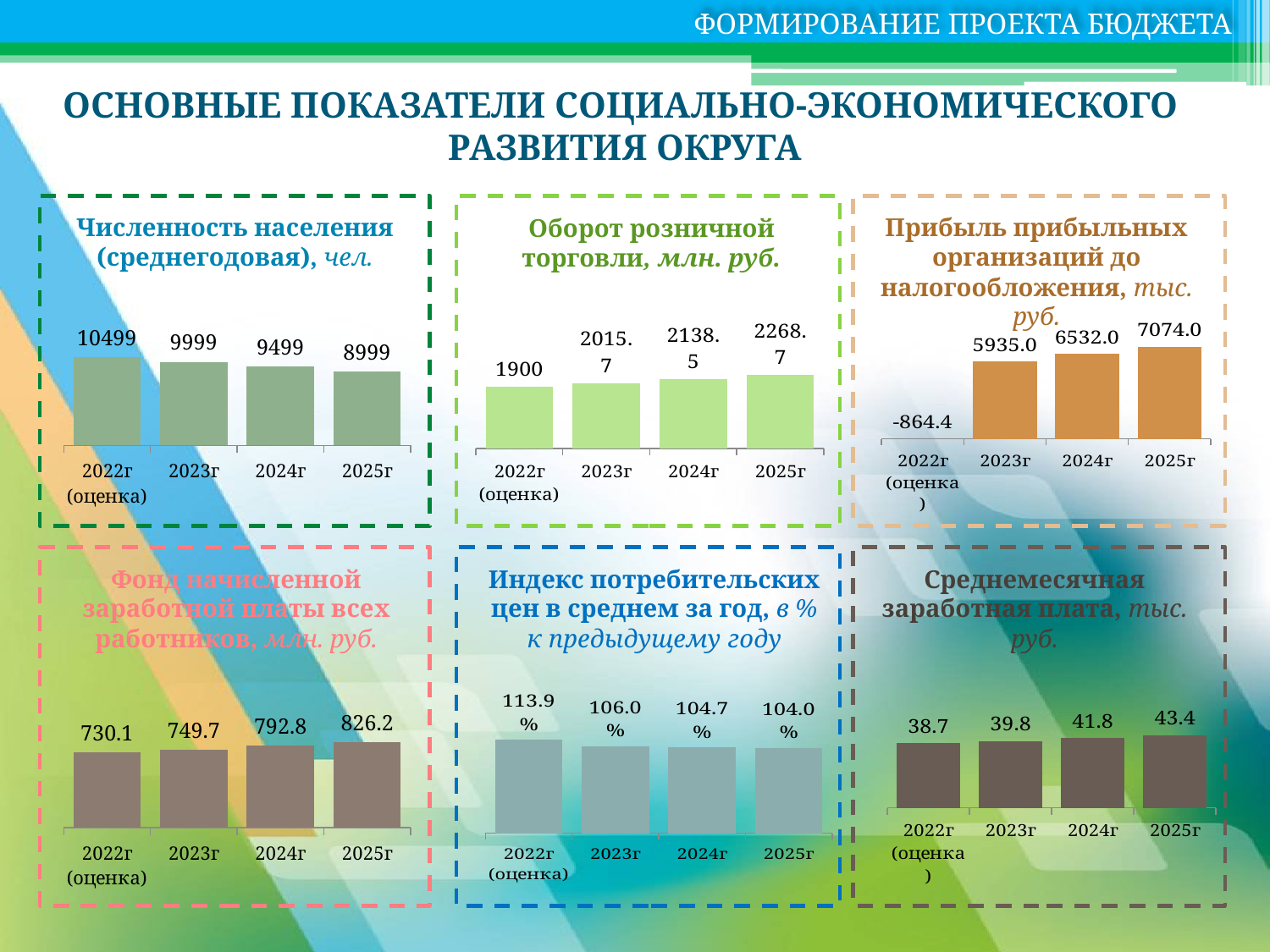
In the chart 'Прибыль прибыльных организаций до налогообложения, тыс. руб.', what is the difference between the values for 2025г and 2024г? 542.0 In the chart 'Численность населения (среднегодовая), чел.', what is the value for 2025г? 8999 In the chart 'Индекс потребительских цен в среднем за год', is the value for 2023г larger or smaller than the value for 2025г? larger In the chart 'Оборот розничной торговли, млн. руб.', what is the value for 2024г? 2138.5 In the chart 'Оборот розничной торговли, млн. руб.', which year has the highest value? 2025г In the chart 'Среднемесячная заработная плата, тыс. руб.', what is the difference between the values for 2025г and 2022г (оценка)? 4.7 In the chart 'Численность населения (среднегодовая), чел.', do the values rise or fall from 2022г to 2025г? fall In the chart 'Прибыль прибыльных организаций до налогообложения, тыс. руб.', what is the value for 2022г (оценка)? -864.4 In the chart 'Фонд начисленной заработной платы всех работников, млн. руб.', which year has the lowest value? 2022г (оценка) How many bars are shown in the chart 'Среднемесячная заработная плата, тыс. руб.'? 4 In the chart 'Индекс потребительских цен в среднем за год', what is the value for 2022г (оценка)? 113.9% In the chart 'Фонд начисленной заработной платы всех работников, млн. руб.', what is the value for 2023г? 749.7